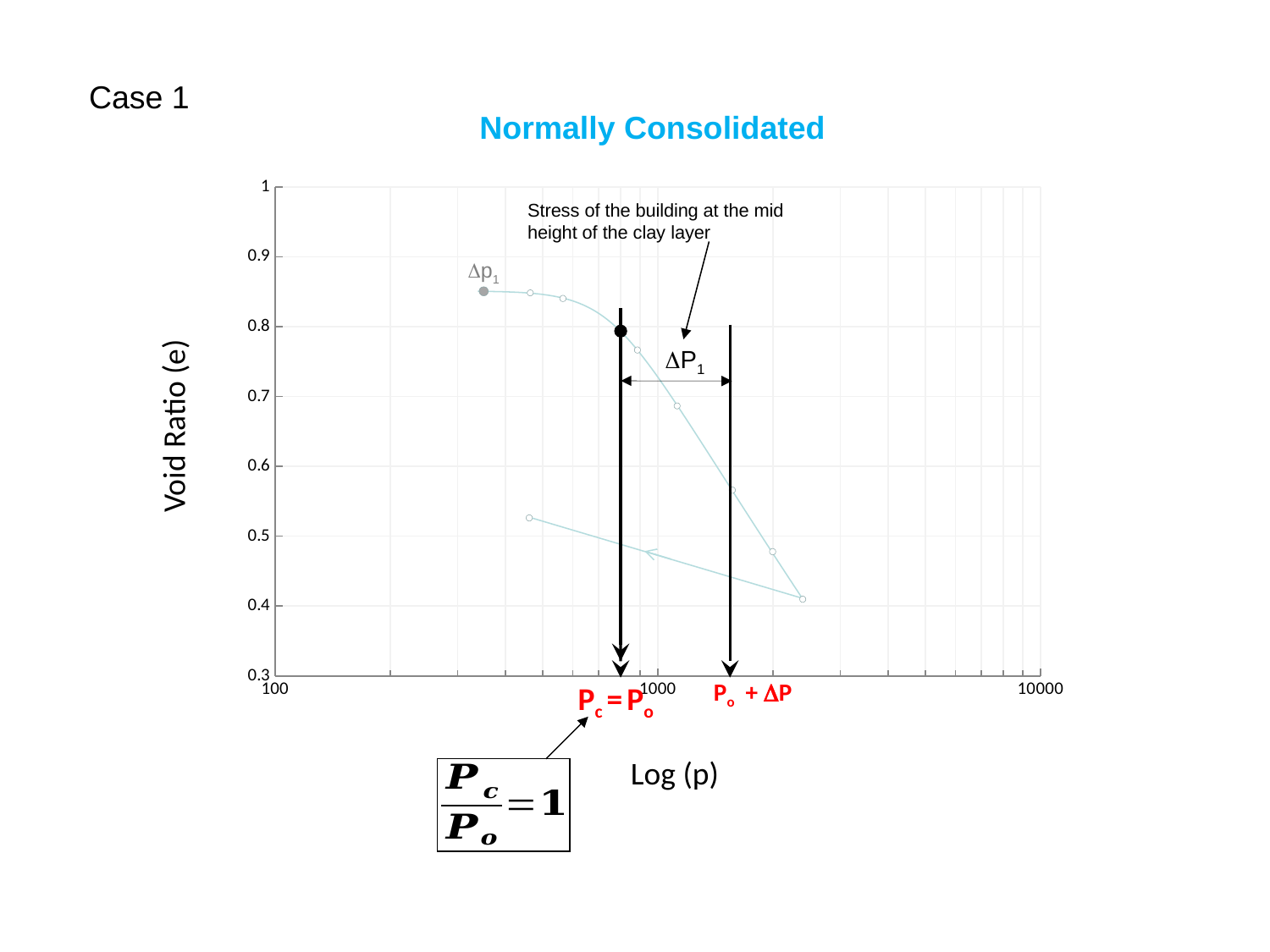
Is the void ratio at the point marked Po + ΔP greater or less than 0.7? less Which point has the higher void ratio: the one at Pc = Po or the one at Po + ΔP? Pc = Po Is the void ratio at the point marked Pc = Po greater or less than 0.9? less Is the lowest void ratio reached by the curve greater or less than 0.5? less What is the label of the vertical axis? Void Ratio (e) What is the highest value shown on the vertical axis? 1 What is the lowest value shown on the vertical axis? 0.3 What kind of chart is shown on the slide? line chart Does the void ratio rise or fall as Log (p) increases along the main consolidation curve? fall